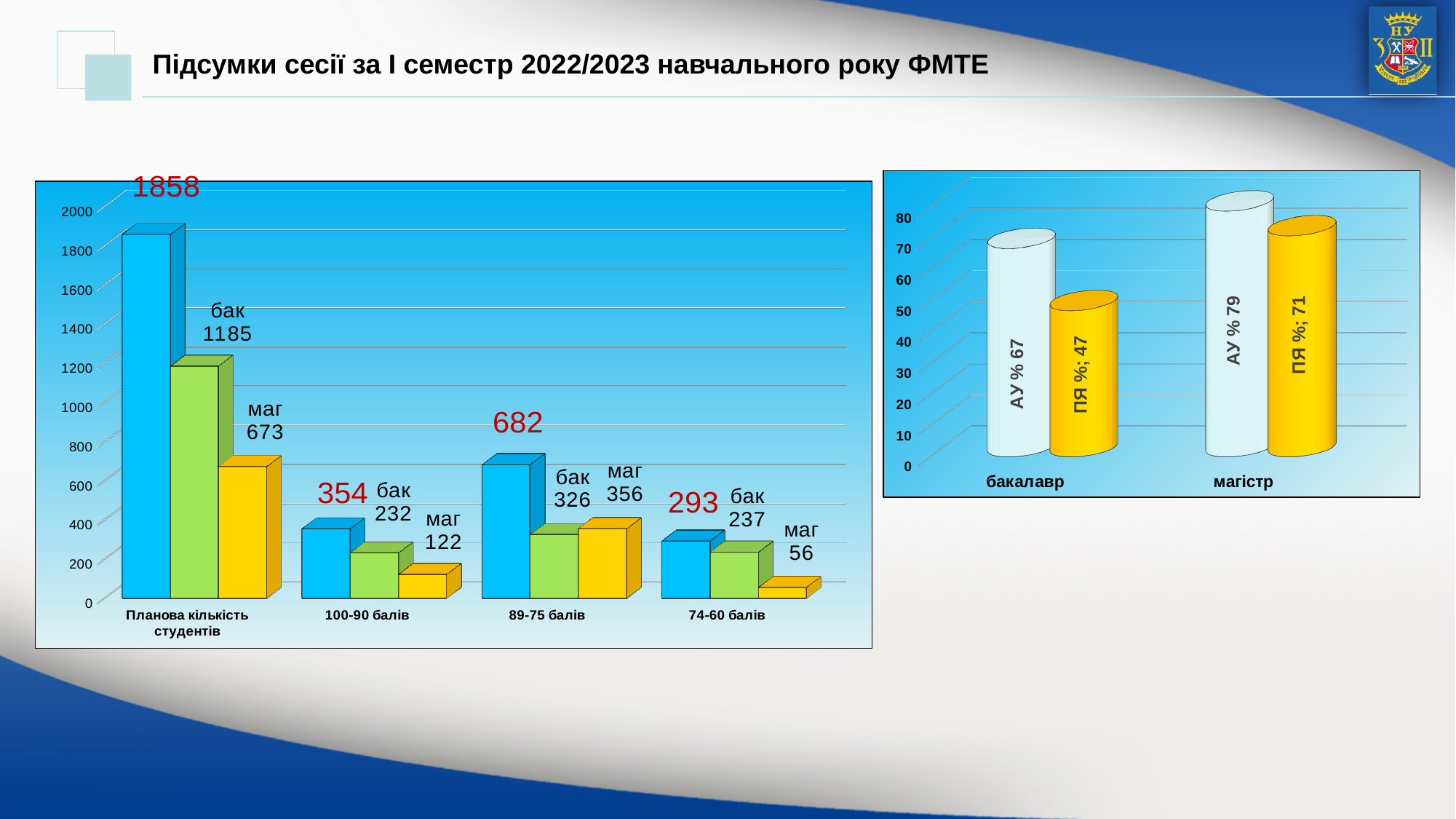
In the right chart, what is the difference between the 'АУ %' and 'ПЯ %' values for 'бакалавр'? 20 In the left chart, which category has the lowest total (red label) value? 74-60 балів In the right chart, what is the 'АУ %' value for 'магістр'? 79 How many categories are shown on the x axis of the left chart? 4 In the left chart, what is the 'маг' value for '74-60 балів'? 56 What type of chart is the left chart? bar chart In the left chart, what is the 'маг' value for '89-75 балів'? 356 In the left chart, what is the total value shown for 'Планова кількість студентів'? 1858 In the left chart, what is the difference between the 'бак' and 'маг' values for 'Планова кількість студентів'? 512 In the right chart, what is the 'ПЯ %' value for 'бакалавр'? 47 In the left chart, what is the 'бак' value for '100-90 балів'? 232 In the left chart, for '89-75 балів', which is larger: the 'бак' value or the 'маг' value? маг